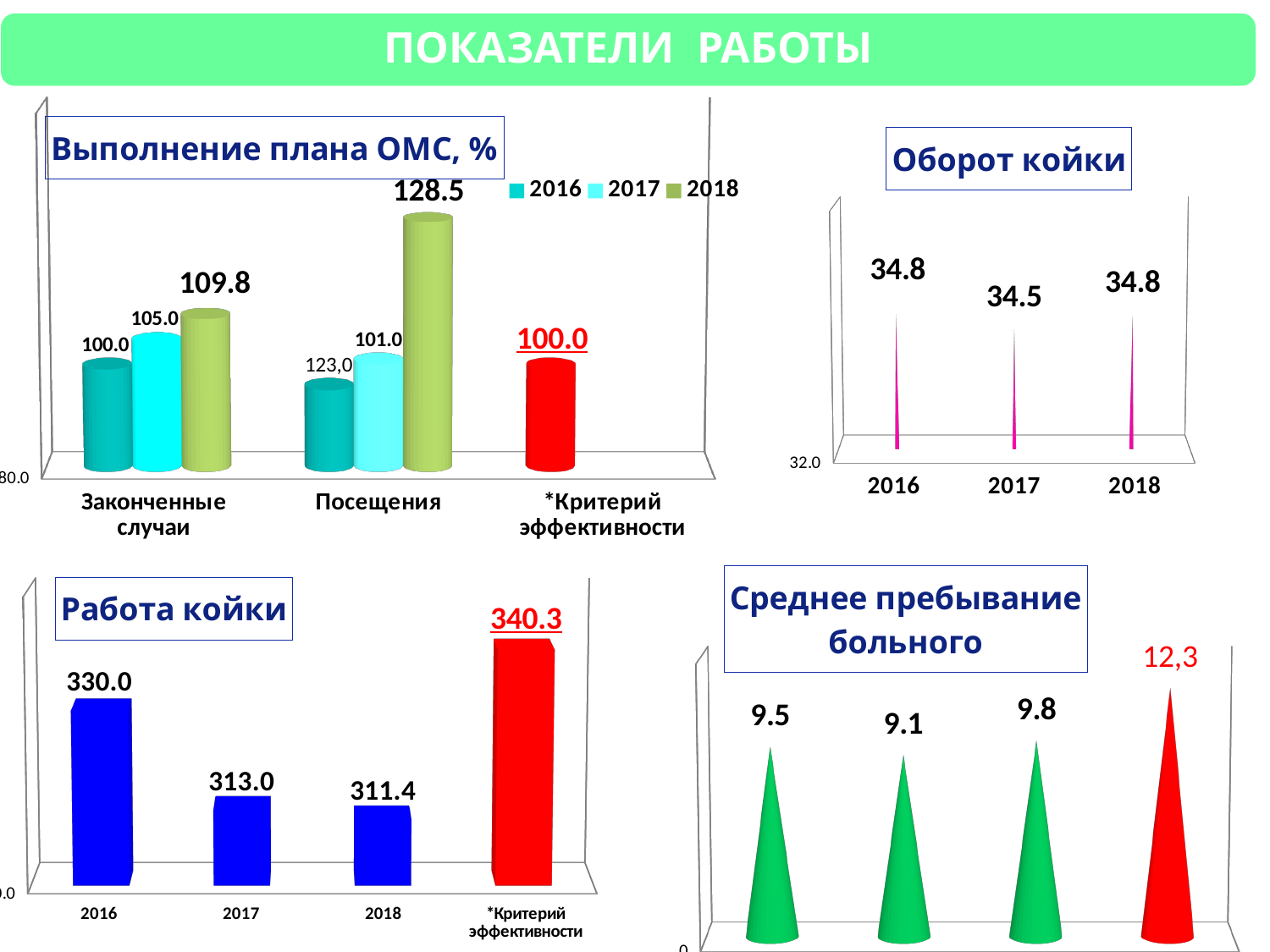
In the chart titled "Оборот койки", what is the value for 2017? 34.5 In the chart titled "Работа койки", which category has the highest value? *Критерий эффективности In the chart titled "Выполнение плана ОМС, %", what is the value for Посещения in 2018? 128.5 In the chart titled "Работа койки", what is the difference between the 2016 and 2018 values? 18.6 In the chart titled "Среднее пребывание больного", what is the highest value shown? 12,3 In the chart titled "Среднее пребывание больного", how many cones are plotted? 4 In the chart titled "Выполнение плана ОМС, %", how many series does the legend list? 3 In the chart titled "Выполнение плана ОМС, %", what is the difference between the 2018 and 2017 values for Законченные случаи? 4.8 In the chart titled "Работа койки", what is the value for 2016? 330.0 In the chart titled "Выполнение плана ОМС, %", what is the value for Законченные случаи in 2018? 109.8 In the chart titled "Оборот койки", which year has the lowest value? 2017 In the chart titled "Работа койки", do the values rise or fall from 2016 to 2018? fall